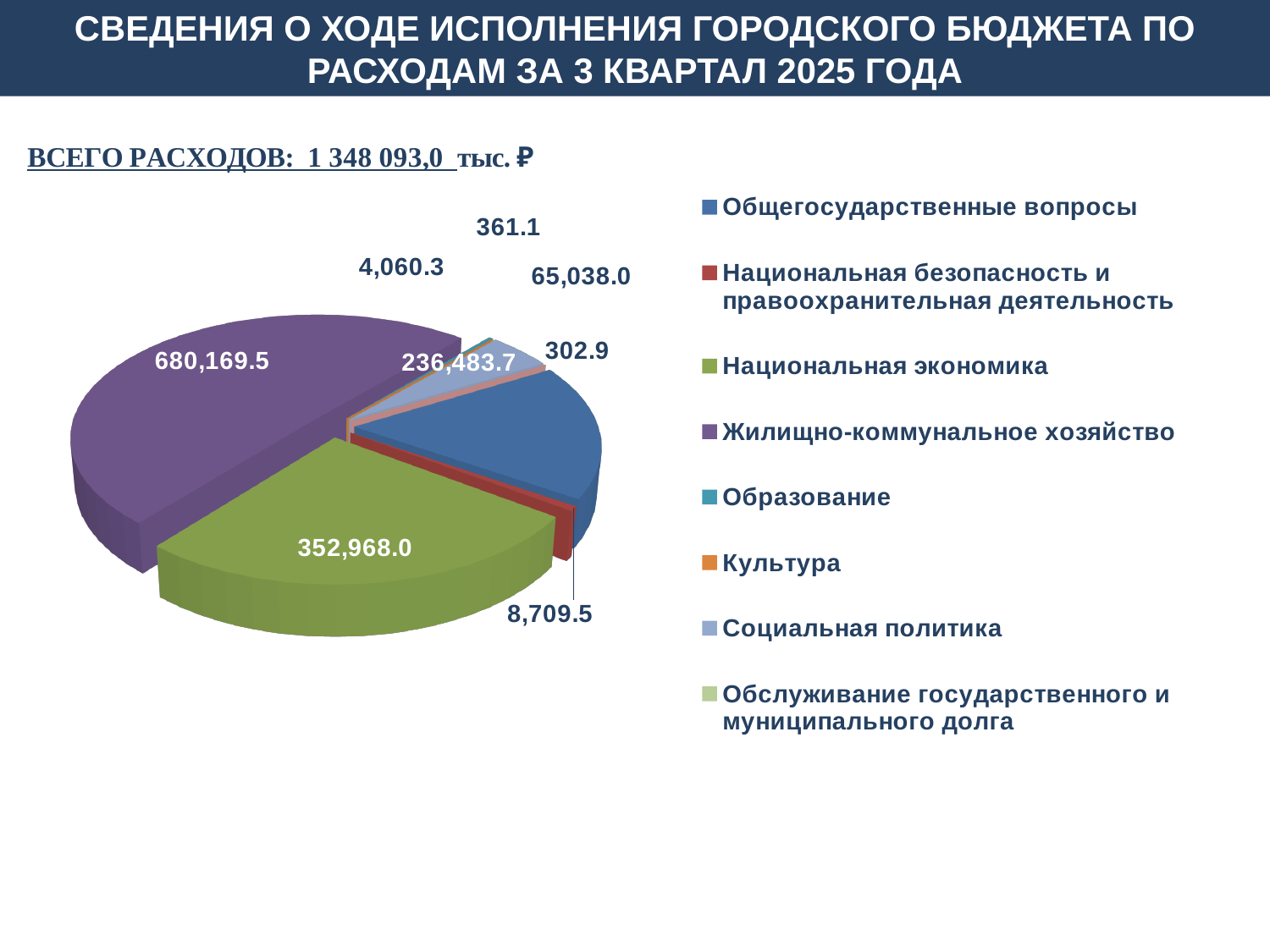
What is the smallest value labelled on the pie chart? 302.9 What is the difference between Жилищно-коммунальное хозяйство and Национальная экономика? 327,201.5 Which category has the largest slice of the pie? Жилищно-коммунальное хозяйство How many categories does the legend of the pie chart list? 8 What is the value for Жилищно-коммунальное хозяйство? 680,169.5 What is the value for Социальная политика? 65,038.0 What is the value for Национальная экономика? 352,968.0 What total expenditure is stated on the slide? 1 348 093,0 тыс. ₽ What is the value for Общегосударственные вопросы? 236,483.7 What kind of chart is shown on the slide? Pie chart Which is larger, Национальная экономика or Общегосударственные вопросы? Национальная экономика What is the value for Национальная безопасность и правоохранительная деятельность? 8,709.5